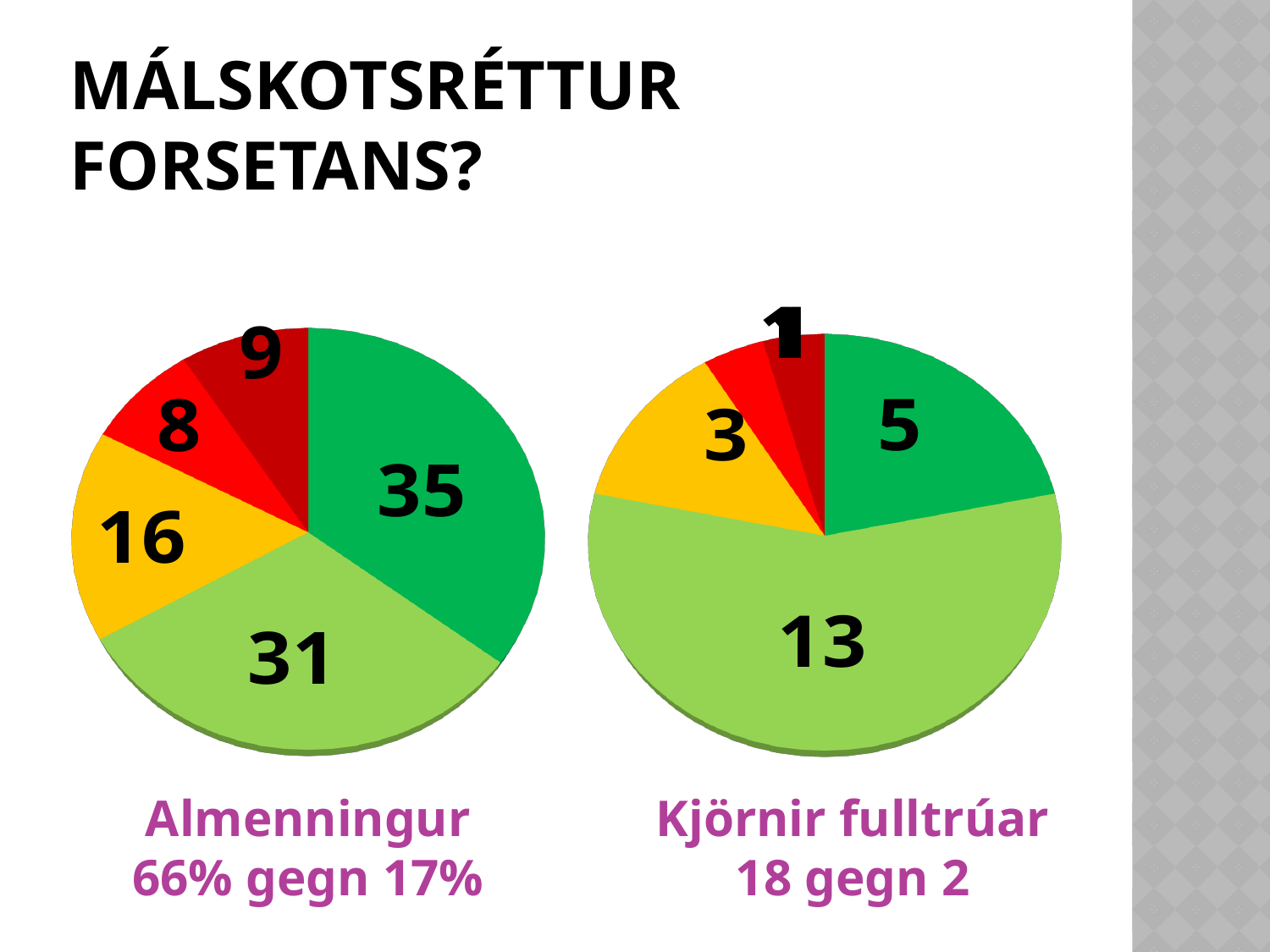
What caption is written under the left chart? Almenningur 66% gegn 17% In the left chart (Almenningur), what value is shown for the yellow slice? 16 In the left chart (Almenningur), what value is shown for the dark green slice? 35 In the left chart (Almenningur), what is the difference between the dark green slice and the light green slice? 4 How many slices does the left chart (Almenningur) have? 5 In the left chart (Almenningur), which slice is the largest? the dark green slice (35) In the right chart (Kjörnir fulltrúar), what value is shown for the yellow slice? 3 In the right chart (Kjörnir fulltrúar), what value is shown for the light green slice? 13 In the right chart (Kjörnir fulltrúar), which slice is the largest? the light green slice (13) What kind of chart is the left chart (Almenningur)? pie chart In the right chart (Kjörnir fulltrúar), what is the difference between the light green slice and the dark green slice? 8 In the left chart (Almenningur), which slice is the smallest? the red slice (8)